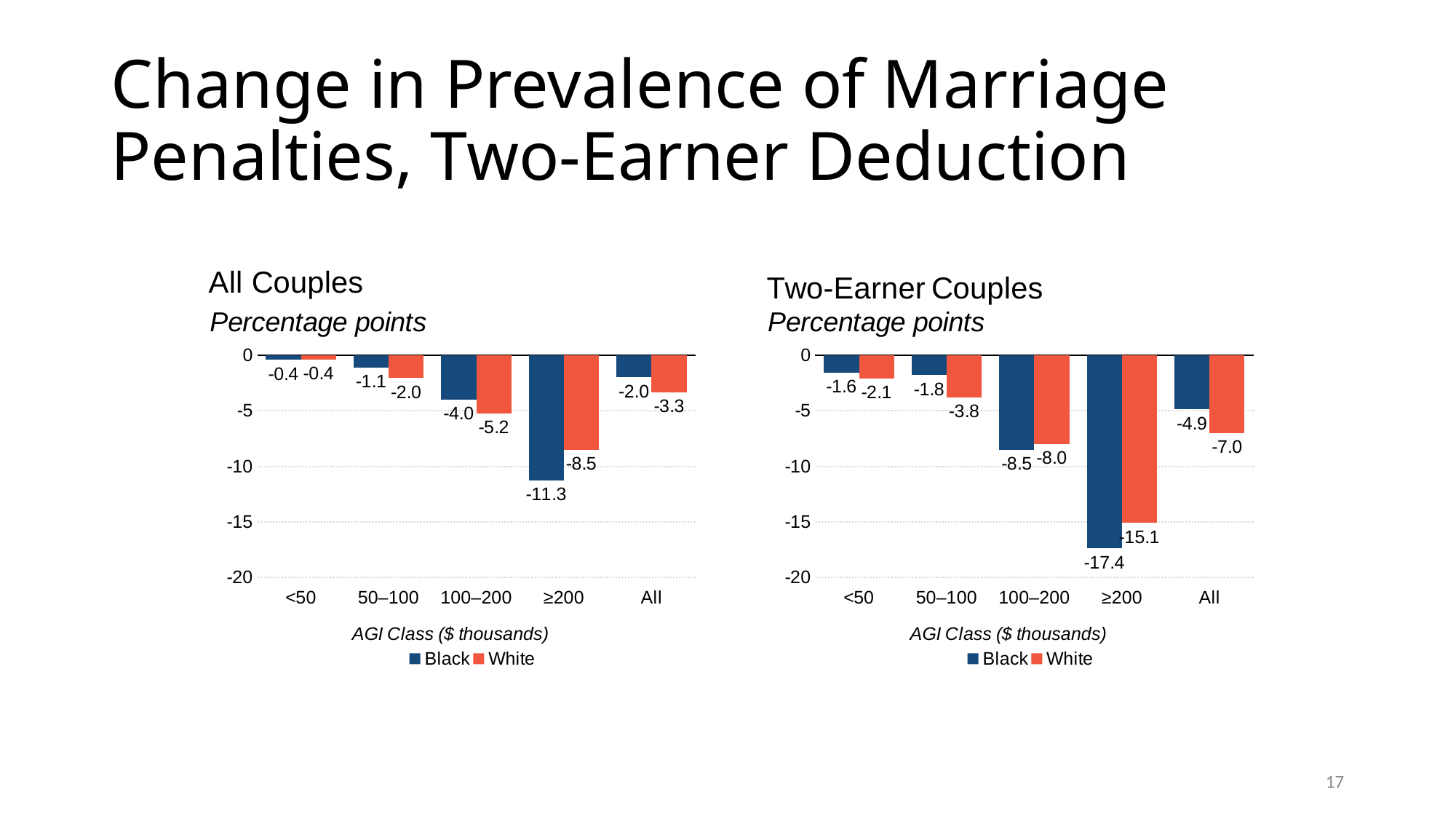
In the All Couples chart, what is the difference between the Black and White values in the ≥200 AGI class? 2.8 In the Two-Earner Couples chart, what is the value for White in the All AGI class? -7.0 In the All Couples chart, what is the value for Black in the ≥200 AGI class? -11.3 In the Two-Earner Couples chart, which AGI class has the lowest (most negative) value for Black? ≥200 In the All Couples chart, which is more negative in the All AGI class, Black or White? White How many AGI classes are shown on the x axis of the All Couples chart? 5 In the All Couples chart, which AGI class has the lowest (most negative) value for White? ≥200 In the Two-Earner Couples chart, what is the difference between the White and Black values in the 50–100 AGI class? 2.0 How many series does the legend of the Two-Earner Couples chart list? 2 In the Two-Earner Couples chart, what is the value for Black in the 100–200 AGI class? -8.5 What type of chart is the All Couples chart? Bar chart In the Two-Earner Couples chart, which is more negative in the ≥200 AGI class, Black or White? Black